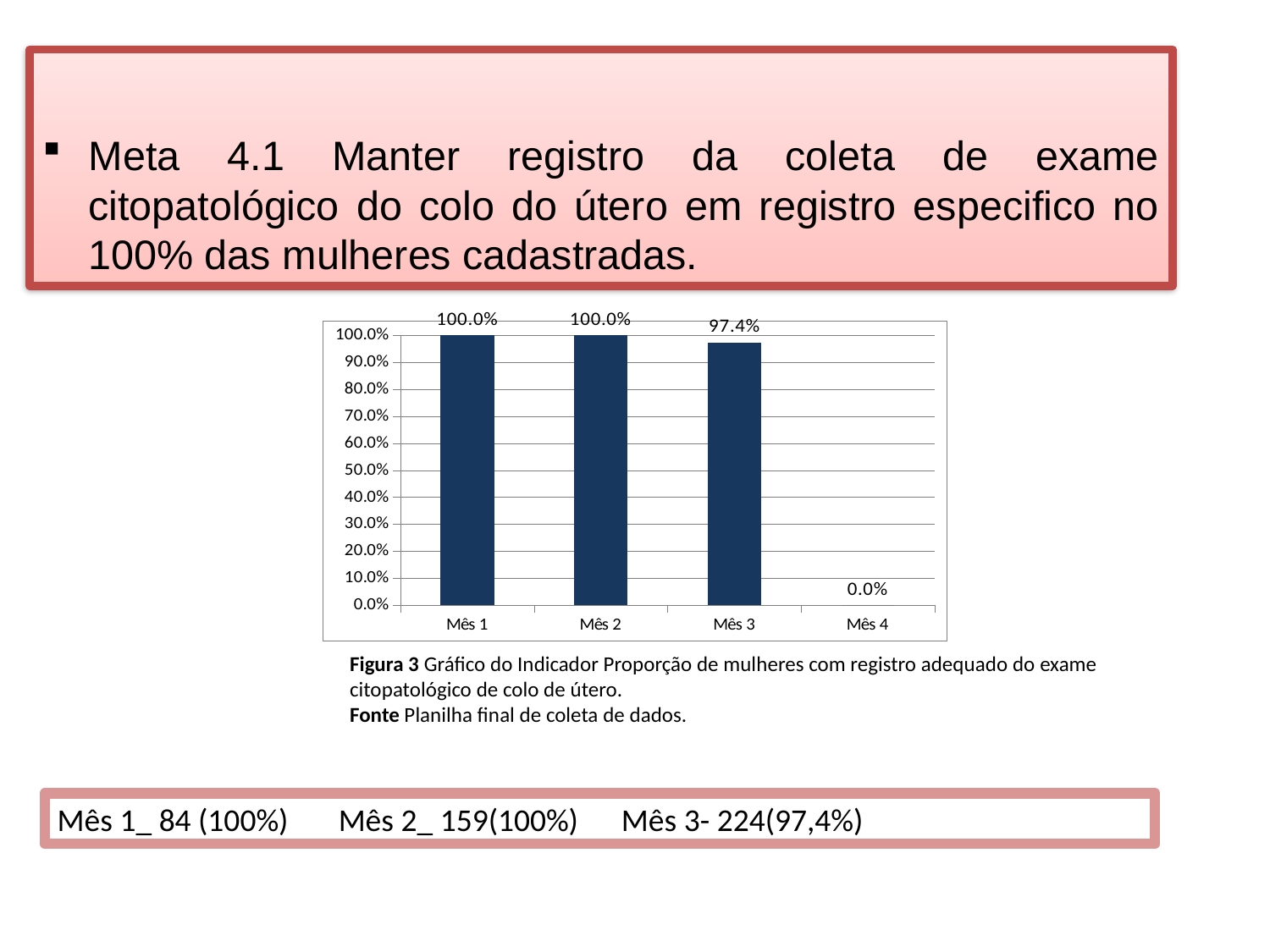
Do the values rise or fall from Mês 2 to Mês 4? fall What is the difference between the values for Mês 2 and Mês 3? 2.6% Which category has the lowest value? Mês 4 What is the value for Mês 3? 97.4% Which is larger, the value for Mês 1 or the value for Mês 3? Mês 1 Is the value for Mês 3 greater or less than 90.0%? greater How many categories are shown on the x axis? 4 What colour are the bars in the chart? dark blue What is the difference between the values for Mês 1 and Mês 4? 100.0% What is the value for Mês 4? 0.0% What kind of chart is shown on the slide? bar chart What is the value for Mês 1? 100.0%